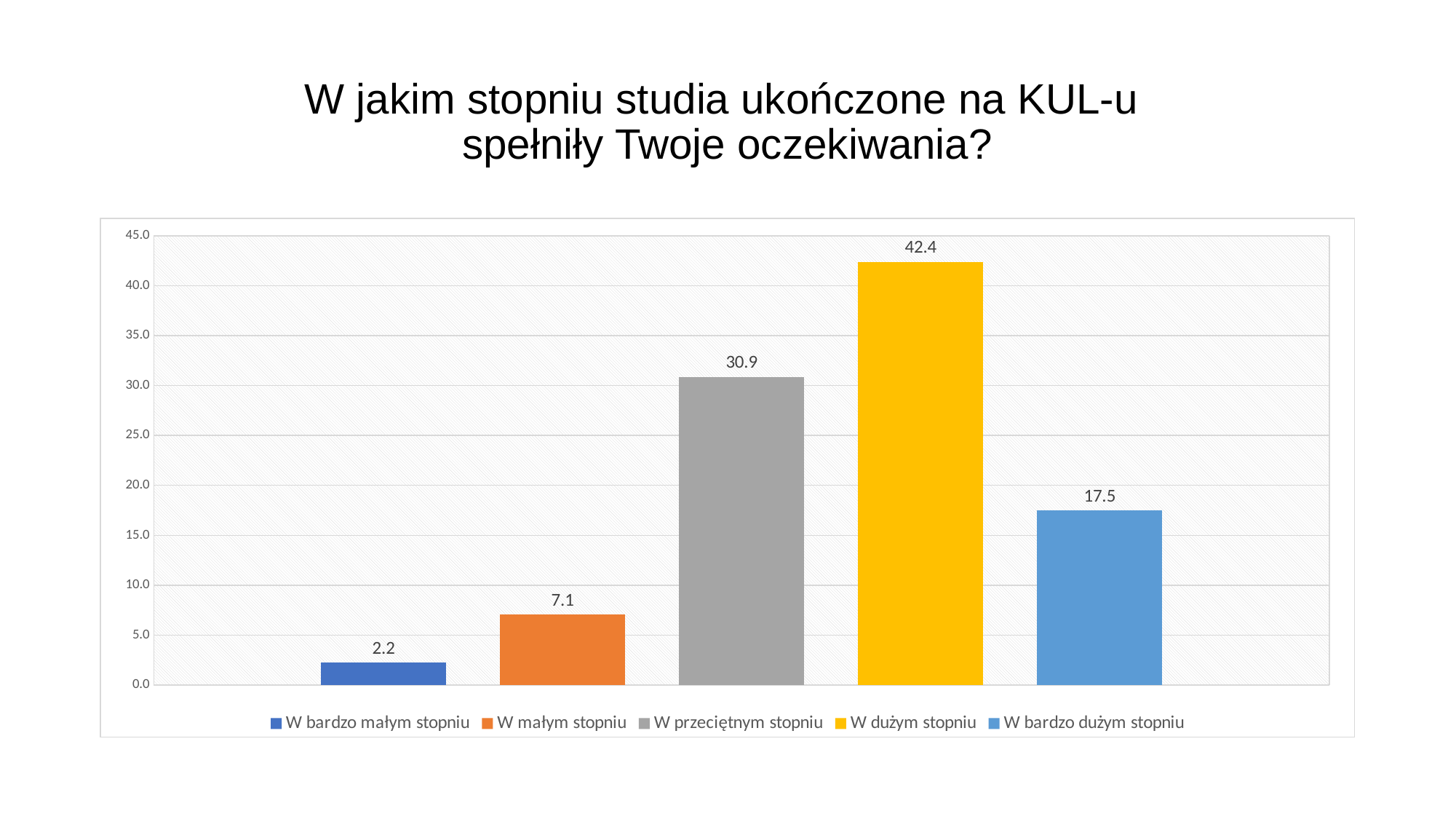
Which is larger, the value for "W małym stopniu" or the value for "W bardzo dużym stopniu"? W bardzo dużym stopniu Which category has the highest value? W dużym stopniu What is the value for "W bardzo dużym stopniu"? 17.5 What colour is the bar for "W dużym stopniu"? Yellow What is the value for "W przeciętnym stopniu"? 30.9 What is the difference between the values for "W dużym stopniu" and "W przeciętnym stopniu"? 11.5 What kind of chart is shown on the slide? Bar chart Is the value for "W przeciętnym stopniu" greater or less than 25.0? greater How many bars are shown in the chart? 5 What is the value for "W bardzo małym stopniu"? 2.2 What is the value for "W dużym stopniu"? 42.4 Which category has the lowest value? W bardzo małym stopniu